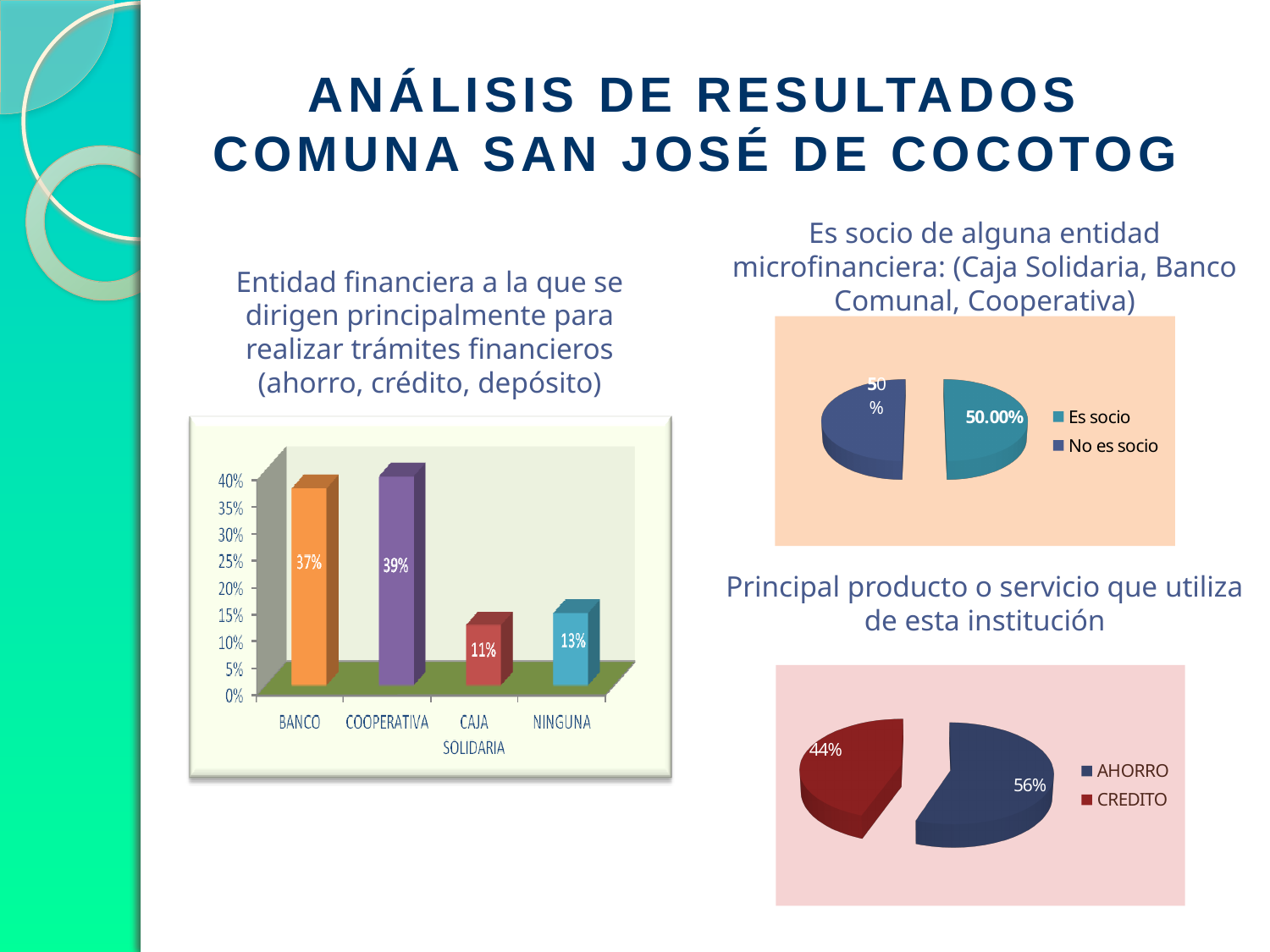
In the bar chart on the left (Entidad financiera a la que se dirigen principalmente), which is larger, the value for BANCO or the value for NINGUNA? BANCO In the bar chart on the left (Entidad financiera a la que se dirigen principalmente), what is the value for CAJA SOLIDARIA? 11% How many series does the legend of the pie chart titled 'Es socio de alguna entidad microfinanciera' list? 2 In the pie chart titled 'Principal producto o servicio que utiliza de esta institución', what share is labelled for AHORRO? 56% In the bar chart on the left (Entidad financiera a la que se dirigen principalmente), what is the value for COOPERATIVA? 39% In the bar chart on the left (Entidad financiera a la que se dirigen principalmente), how many categories are shown? 4 In the bar chart on the left (Entidad financiera a la que se dirigen principalmente), which category has the highest value? COOPERATIVA In the pie chart titled 'Es socio de alguna entidad microfinanciera', what share is labelled for 'Es socio'? 50.00% In the pie chart titled 'Principal producto o servicio que utiliza de esta institución', which slice is larger, AHORRO or CREDITO? AHORRO In the bar chart on the left (Entidad financiera a la que se dirigen principalmente), what is the difference between the values for BANCO and NINGUNA? 24% What kind of chart is the chart on the left (Entidad financiera a la que se dirigen principalmente)? Bar chart In the bar chart on the left (Entidad financiera a la que se dirigen principalmente), which category has the lowest value? CAJA SOLIDARIA